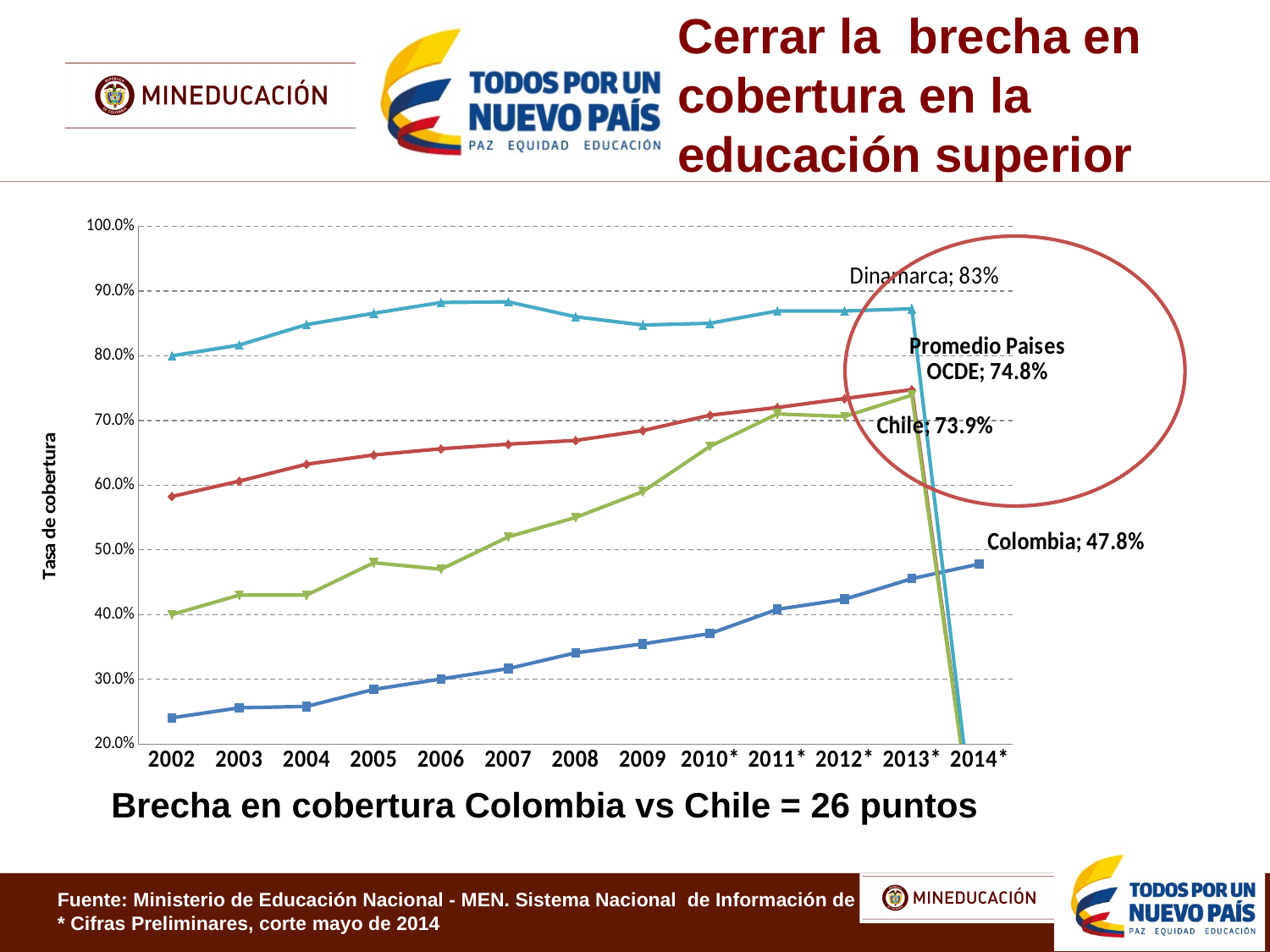
Is the value for Colombia in 2002 greater or less than 30.0%? less What value is labeled for Chile on the chart? 73.9% How many years are shown on the x axis of the chart? 13 What type of chart is shown on the slide? line chart What value is labeled for Promedio Paises OCDE on the chart? 74.8% Which series has the highest labeled value on the chart? Dinamarca What value is labeled for Dinamarca on the chart? 83% What is the difference between the labeled values for Promedio Paises OCDE and Chile? 0.9 percentage points What value is labeled for Colombia on the chart? 47.8% Does the Colombia line rise or fall from 2002 to 2014*? rises What is the label on the y axis of the chart? Tasa de cobertura Which series has the lowest labeled value on the chart? Colombia